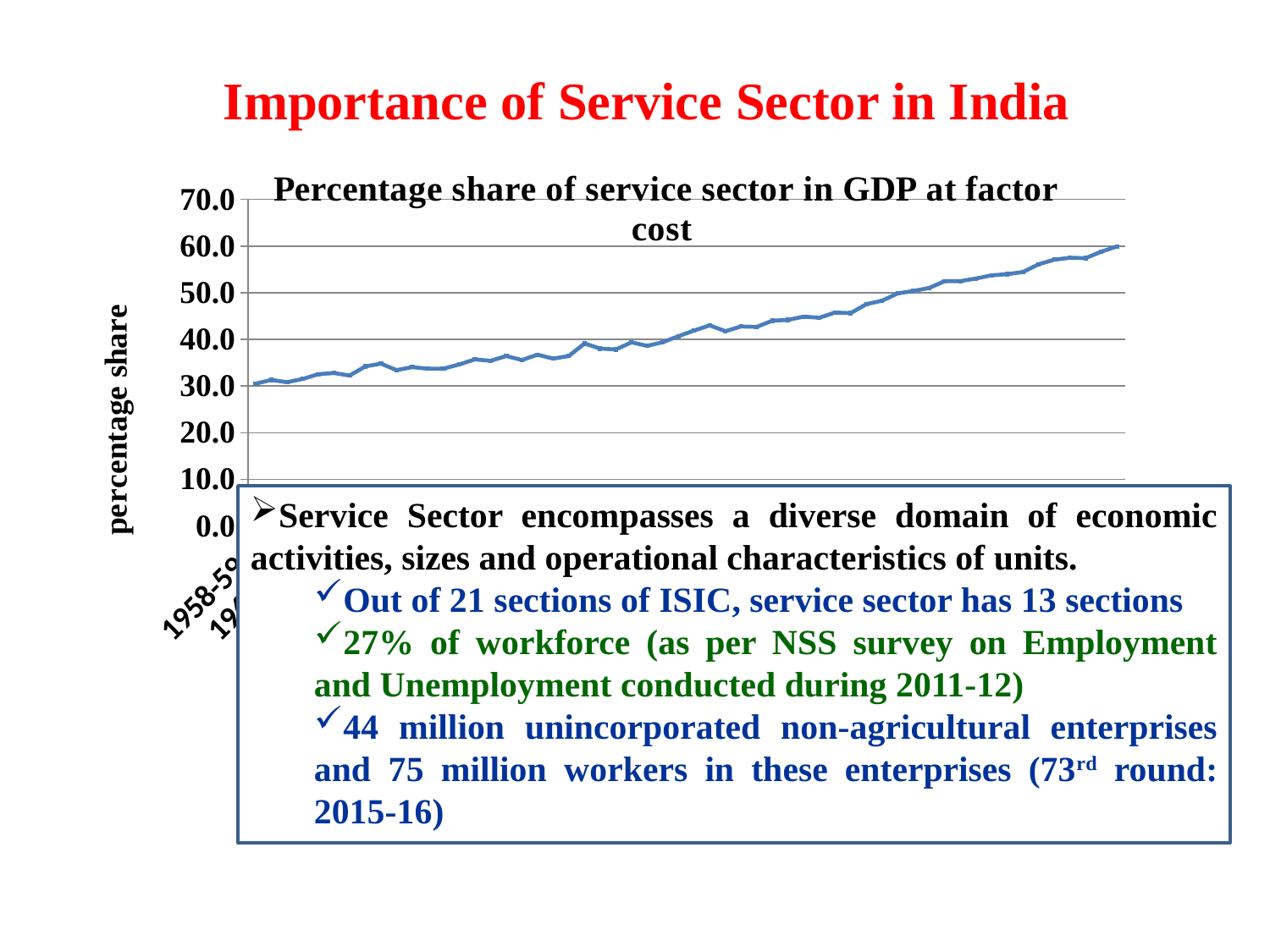
What is the title of the chart? Percentage share of service sector in GDP at factor cost Is the highest point on the line greater or less than 50.0? greater What is the label on the vertical axis of the chart? percentage share Is the value for 1958-59 greater or less than 40.0? less What kind of chart is shown on the slide? line chart Is the value for 1958-59 greater or less than 20.0? greater Do the values in the chart generally rise or fall from left to right along the x axis? rise Is the value for 1958-59 greater or less than the value at the right end of the line? less